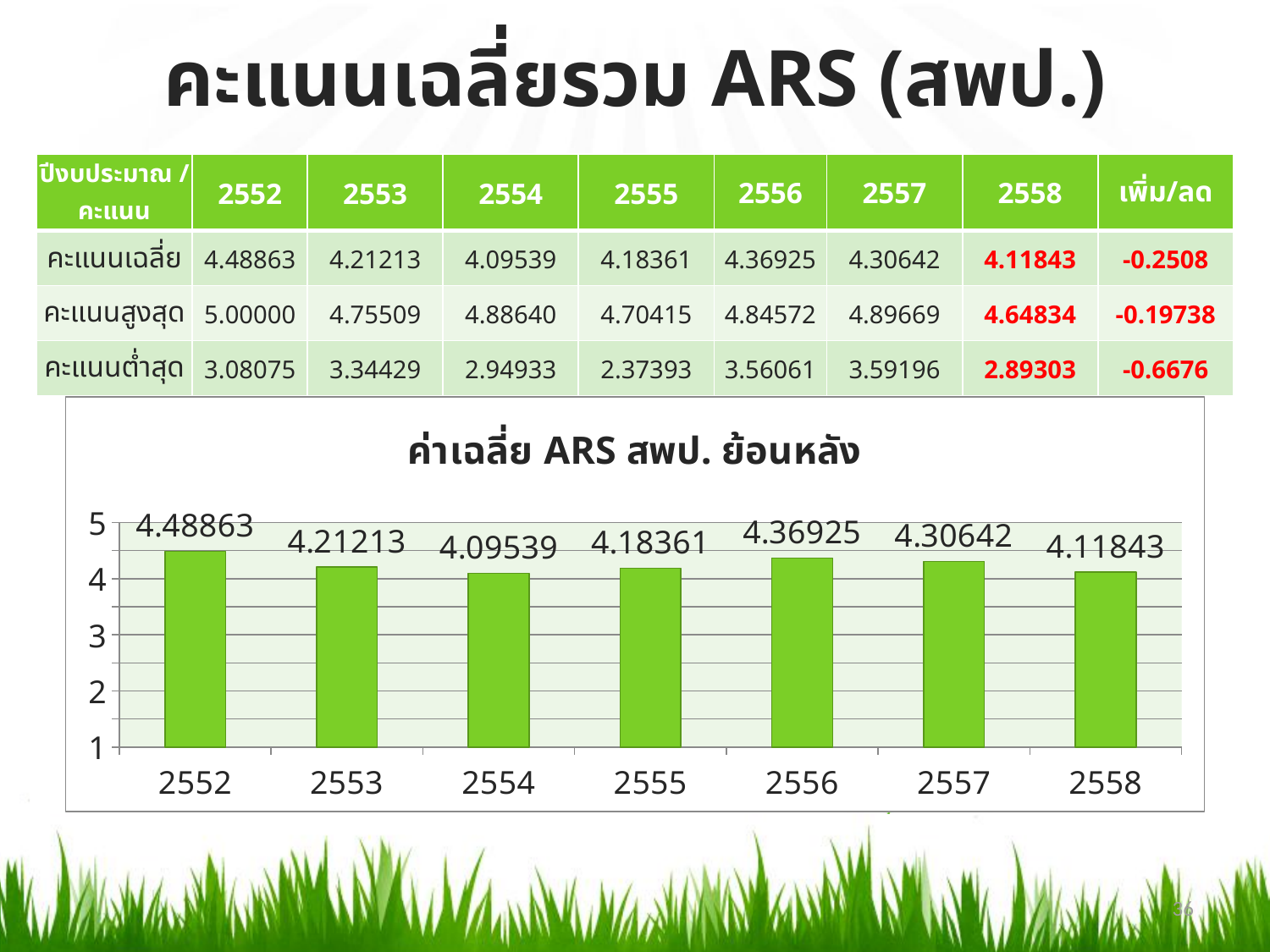
What is the title of the chart on the slide? ค่าเฉลี่ย ARS สพป. ย้อนหลัง Which year has the larger value in the chart, 2556 or 2557? 2556 What type of chart is shown on the slide? bar chart What is the value shown for 2558 in the chart? 4.11843 What is the value shown for 2552 in the chart? 4.48863 Which year has the highest value in the chart? 2552 Is the value for 2554 in the chart greater or less than 4? greater What is the value shown for 2556 in the chart? 4.36925 What is the difference between the values for 2552 and 2553 in the chart? 0.2765 Do the values in the chart rise or fall from 2552 to 2554? fall How many years (bars) are plotted in the chart? 7 Which year has the lowest value in the chart? 2554